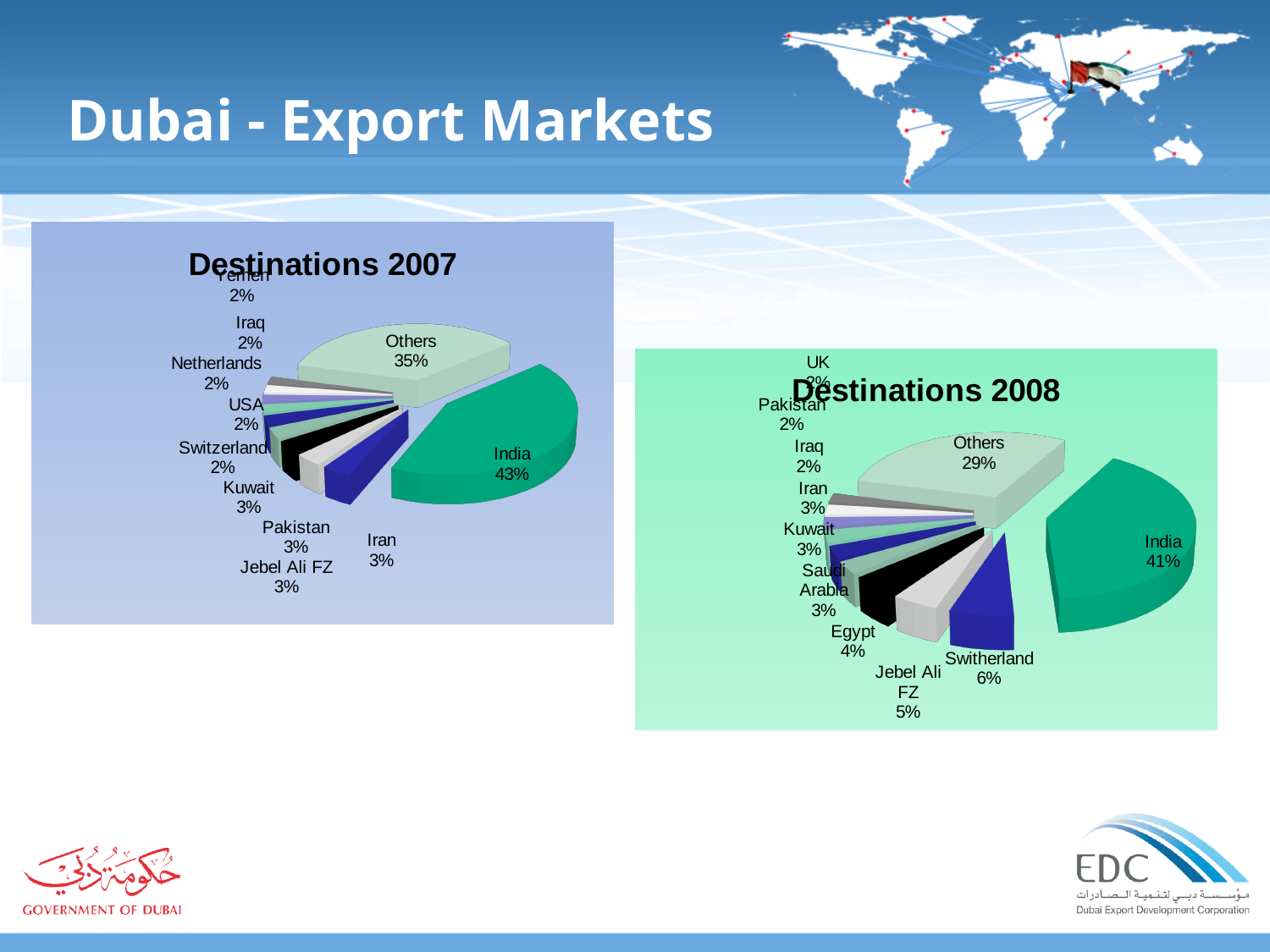
In the Destinations 2008 chart, what share of exports went to India? 41% In the Destinations 2007 chart, what percentage is shown for Others? 35% How many slices does the Destinations 2008 pie chart have? 11 In the Destinations 2008 chart, what is the difference between the shares of India and Others? 12% In the Destinations 2007 chart, what share of exports went to India? 43% In the Destinations 2008 chart, what share of the pie does Egypt represent? 4% What type of chart is Destinations 2007? Pie chart In the Destinations 2007 chart, what is the difference between the shares of India and Others? 8% In the Destinations 2008 chart, which is larger, the share for Jebel Ali FZ or the share for Egypt? Jebel Ali FZ In the Destinations 2008 chart, what percentage is shown for Switherland? 6% In the Destinations 2008 chart, which destination has the largest share? India In the Destinations 2007 chart, which destination has the largest share? India